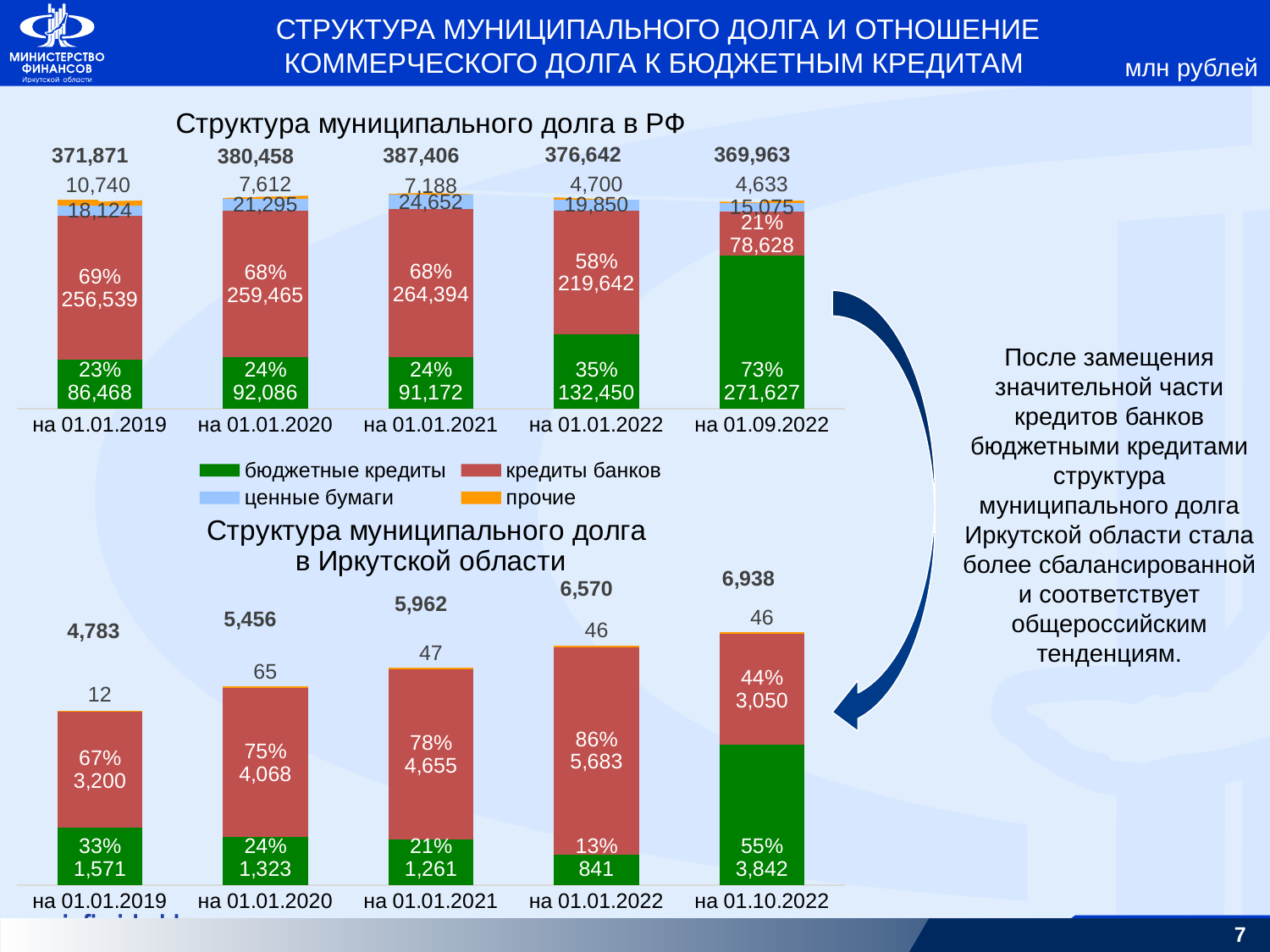
In the chart 'Структура муниципального долга в РФ', how many series does the legend list? 4 In the chart 'Структура муниципального долга в РФ', what is the value of кредиты банков on 01.09.2022? 78,628 In the chart 'Структура муниципального долга в Иркутской области', on which date is the value of бюджетные кредиты the lowest? на 01.01.2022 In the chart 'Структура муниципального долга в РФ', on which date is the total municipal debt the highest? на 01.01.2021 In the chart 'Структура муниципального долга в РФ', what is the total municipal debt on 01.01.2021? 387,406 In the chart 'Структура муниципального долга в Иркутской области', what is the total municipal debt on 01.10.2022? 6,938 In the chart 'Структура муниципального долга в Иркутской области', what is the value of кредиты банков on 01.01.2022? 5,683 In the chart 'Структура муниципального долга в РФ', what is the value of бюджетные кредиты on 01.01.2019? 86,468 What type of chart is 'Структура муниципального долга в Иркутской области'? Stacked bar chart In the chart 'Структура муниципального долга в РФ', what percentage share do бюджетные кредиты have on 01.09.2022? 73% In the chart 'Структура муниципального долга в Иркутской области', what is the difference between бюджетные кредиты on 01.10.2022 and on 01.01.2022? 3,001 In the chart 'Структура муниципального долга в Иркутской области', how many dates are shown on the x axis? 5